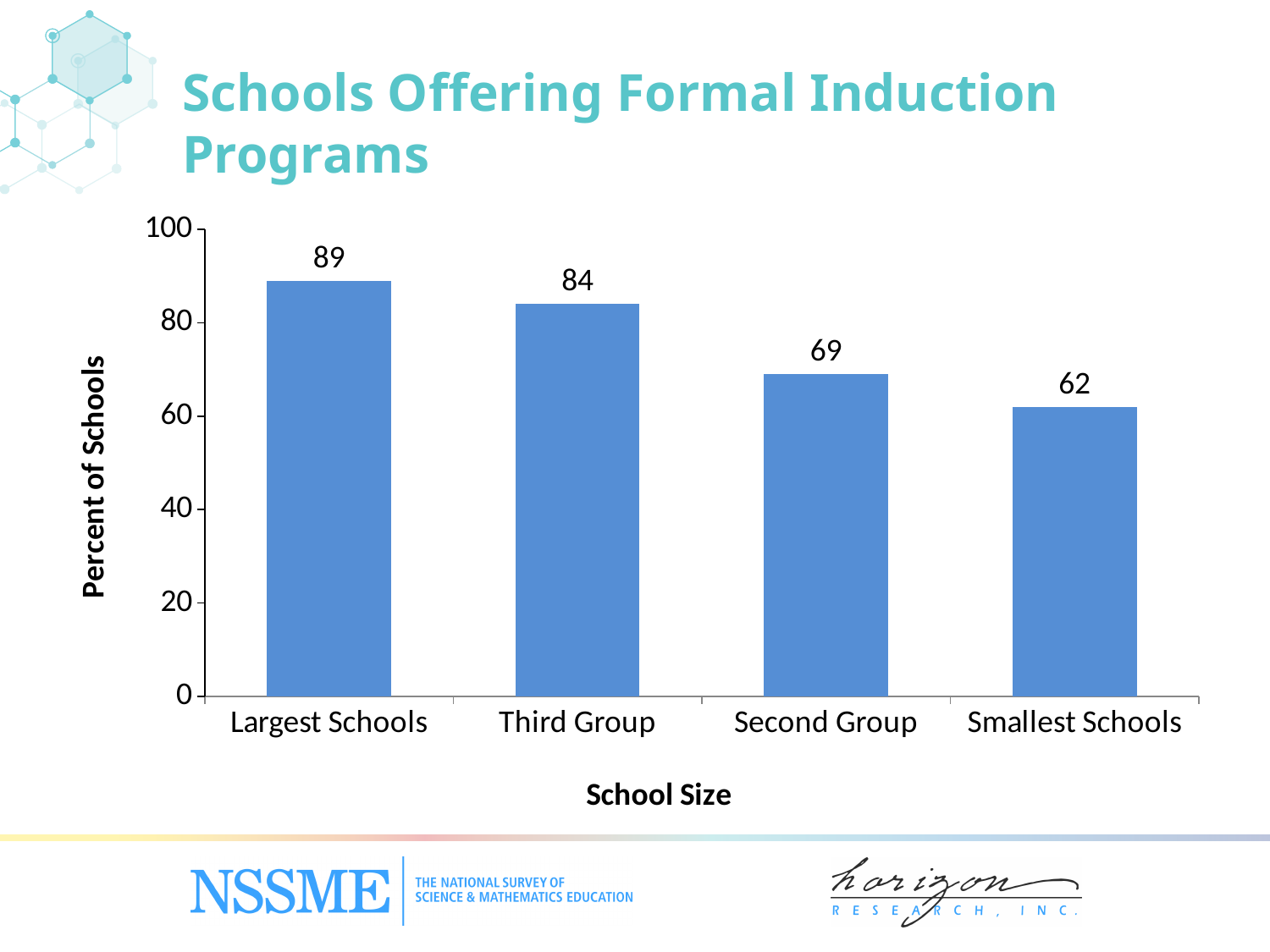
What is the value for Second Group? 69 Which is larger, the value for Third Group or the value for Second Group? Third Group What kind of chart is shown on the slide? bar chart What is the difference between the values for Third Group and Second Group? 15 Which school size category has the lowest percent of schools? Smallest Schools Do the values rise or fall from Largest Schools to Smallest Schools along the x axis? fall What is the value for Largest Schools? 89 Which school size category has the highest percent of schools? Largest Schools What is the difference between the values for Largest Schools and Smallest Schools? 27 What is the value for Smallest Schools? 62 Is the value for Second Group greater or less than 80? less How many school size categories are shown on the chart? 4